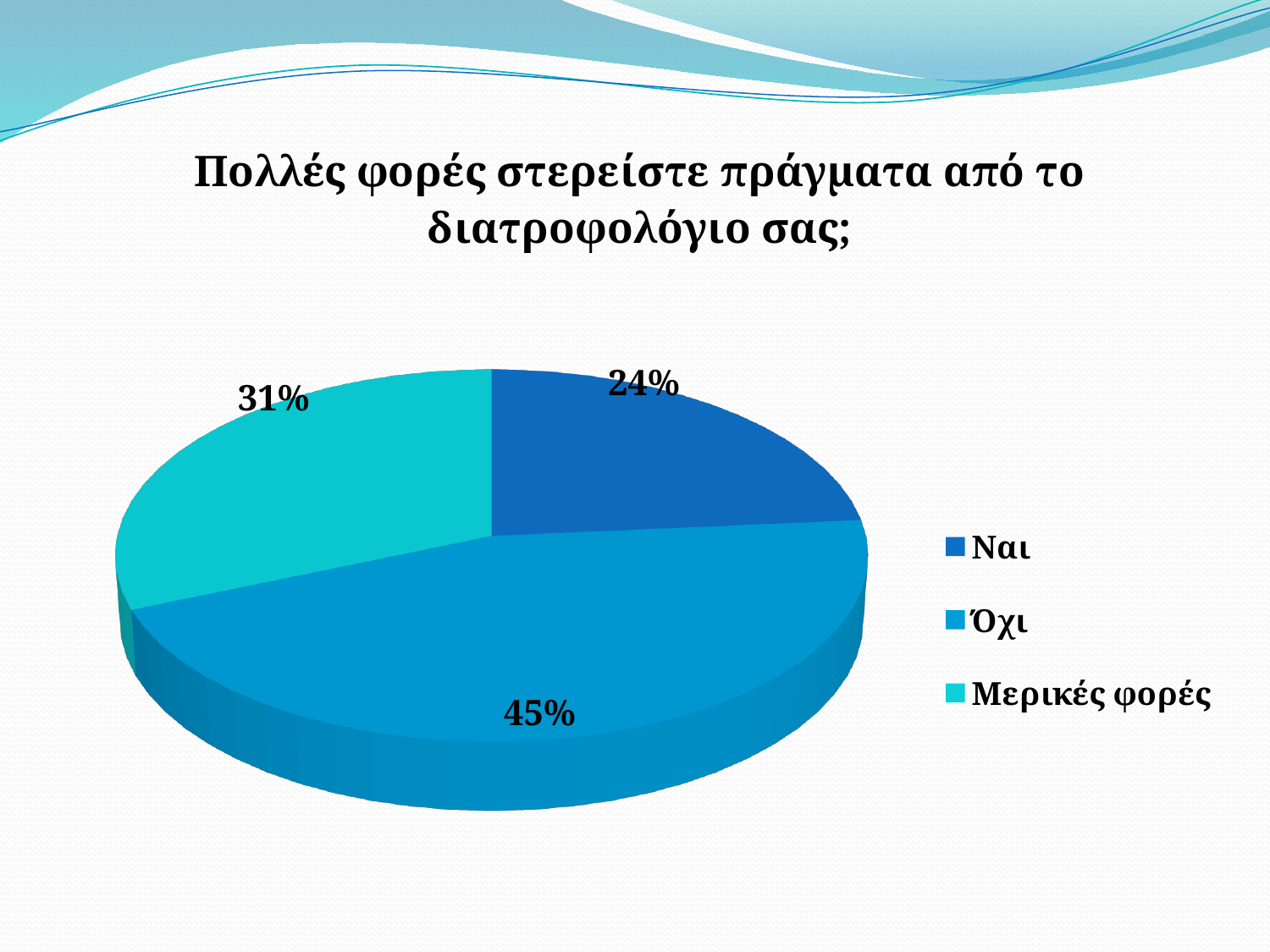
What kind of chart is shown on the slide? pie chart Which category has the smallest slice of the pie? Ναι What percentage of the pie is labelled Όχι? 45% What is the difference in percentage points between the Μερικές φορές slice and the Ναι slice? 7 What percentage of the pie is labelled Μερικές φορές? 31% Which slice is larger, Μερικές φορές or Ναι? Μερικές φορές Which category has the largest slice of the pie? Όχι What is the difference in percentage points between the Όχι slice and the Ναι slice? 21 How many slices does the pie chart have? 3 What is the title of the chart? Πολλές φορές στερείστε πράγματα από το διατροφολόγιο σας; What percentage of the pie is labelled Ναι? 24% How many entries does the legend list? 3